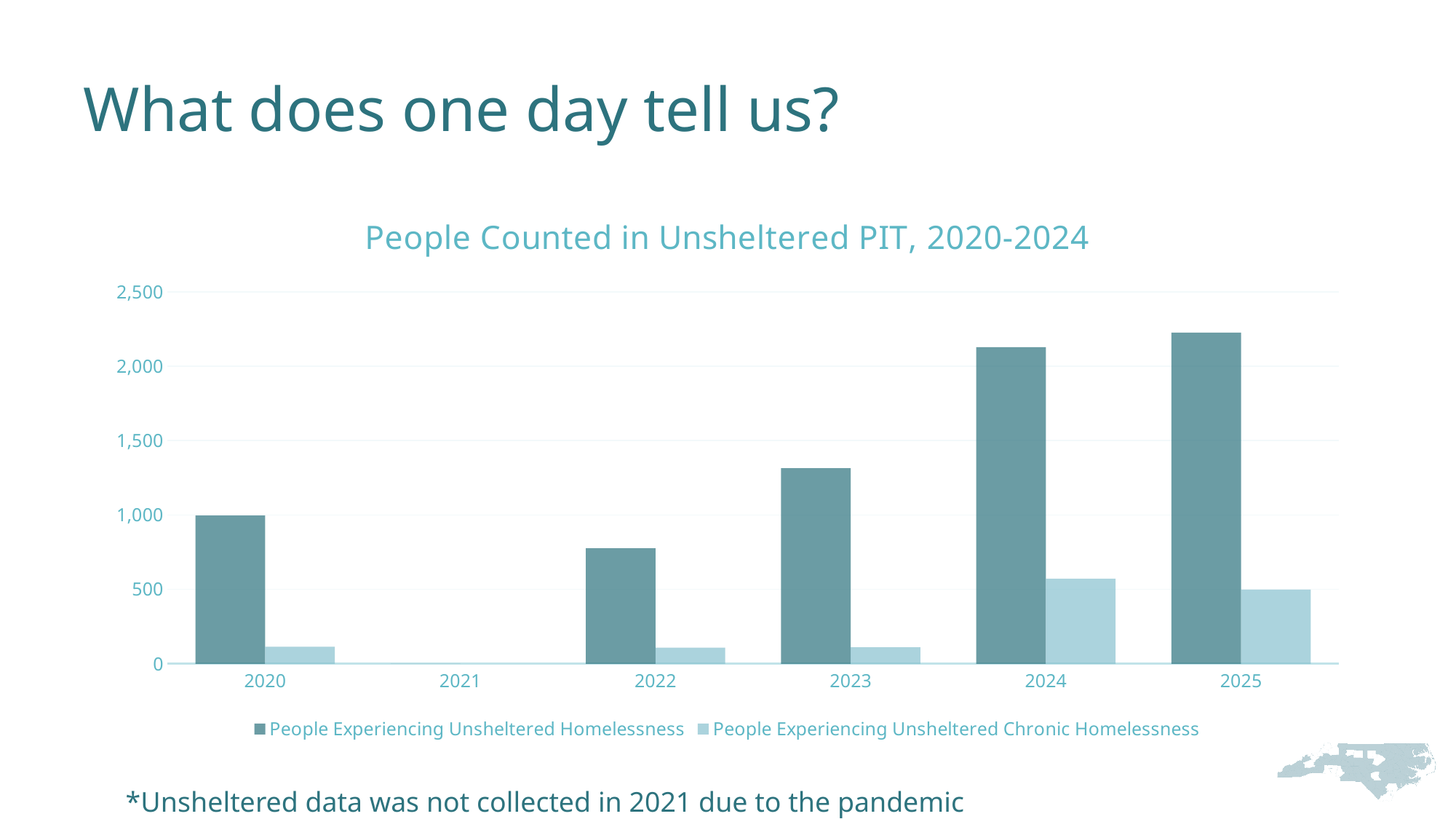
Which year has the highest value for People Experiencing Unsheltered Chronic Homelessness? 2024 Which is larger: People Experiencing Unsheltered Homelessness in 2022 or in 2023? 2023 Among the years with bars plotted, which year has the lowest value for People Experiencing Unsheltered Homelessness? 2022 Is the value for People Experiencing Unsheltered Homelessness in 2022 greater or less than 1,000? less Do the bars for People Experiencing Unsheltered Homelessness rise or fall from 2022 to 2025? rise What kind of chart is shown on the slide? bar chart Which year has the tallest bar for People Experiencing Unsheltered Homelessness? 2025 How many year categories are shown on the x axis? 6 What is the title of the chart? People Counted in Unsheltered PIT, 2020-2024 How many series does the legend list? 2 Is the value for People Experiencing Unsheltered Homelessness in 2024 greater or less than 2,000? greater Is the value for People Experiencing Unsheltered Homelessness in 2023 greater or less than 1,000? greater